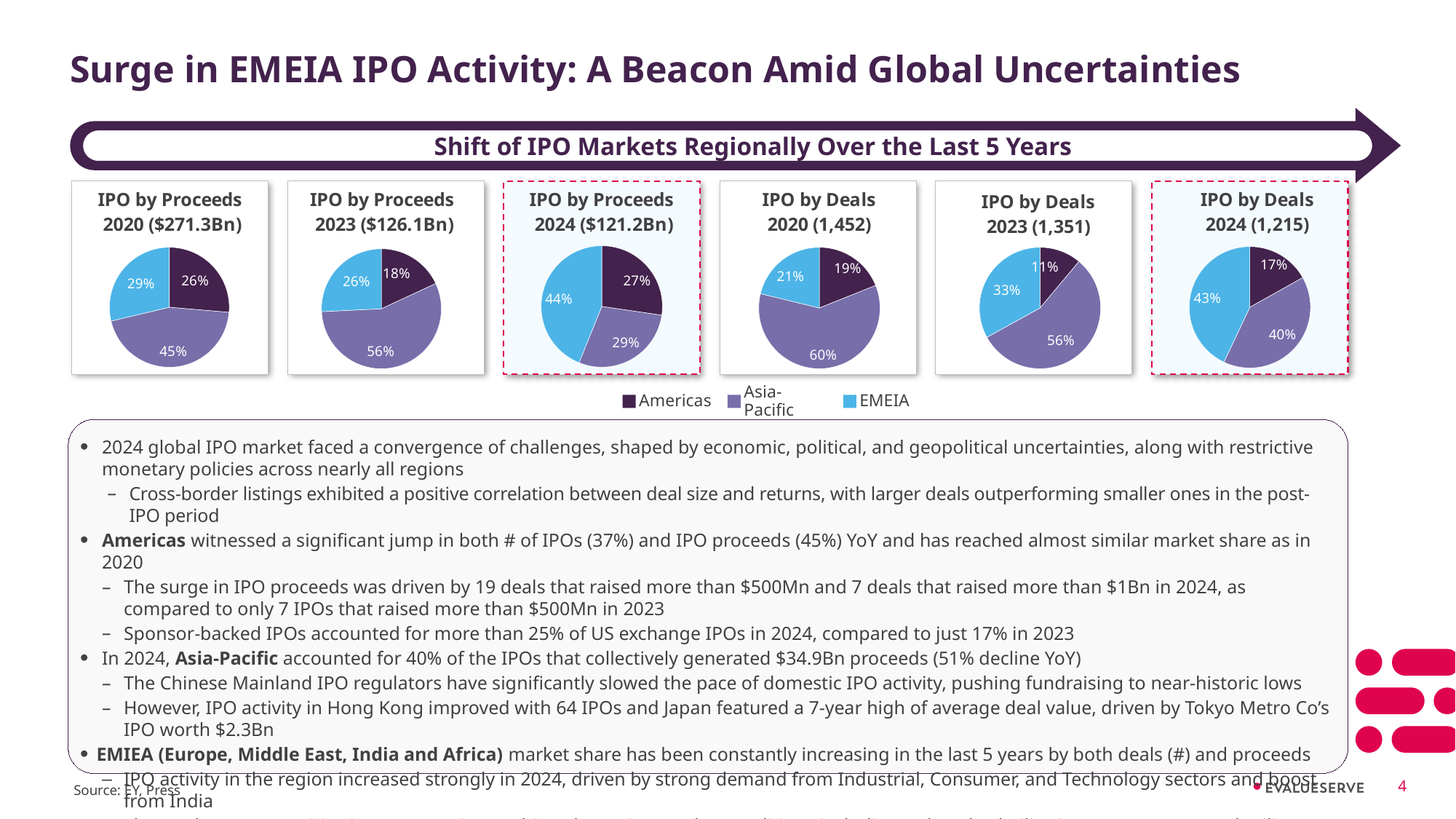
How many regions does the shared legend below the pie charts list? 3 In the 'IPO by Proceeds 2020 ($271.3Bn)' pie chart, what share does Asia-Pacific hold? 45% In the 'IPO by Proceeds 2023 ($126.1Bn)' pie chart, which region has the smallest share? Americas What type of chart is used for 'IPO by Proceeds 2020 ($271.3Bn)'? Pie chart How many pie charts are shown on the slide? 6 In the 'IPO by Deals 2020 (1,452)' pie chart, what is the difference between the Asia-Pacific share and the EMEIA share? 39 percentage points How many slices does the 'IPO by Deals 2023 (1,351)' pie chart have? 3 In the 'IPO by Proceeds 2024 ($121.2Bn)' pie chart, which is larger: the Americas share or the EMEIA share? EMEIA According to the legend, which region is represented by the light blue colour in the pie charts? EMEIA In the 'IPO by Deals 2023 (1,351)' pie chart, what share does Americas hold? 11% In the 'IPO by Deals 2024 (1,215)' pie chart, which region has the largest share? EMEIA In the 'IPO by Proceeds 2024 ($121.2Bn)' pie chart, what share does EMEIA hold? 44%